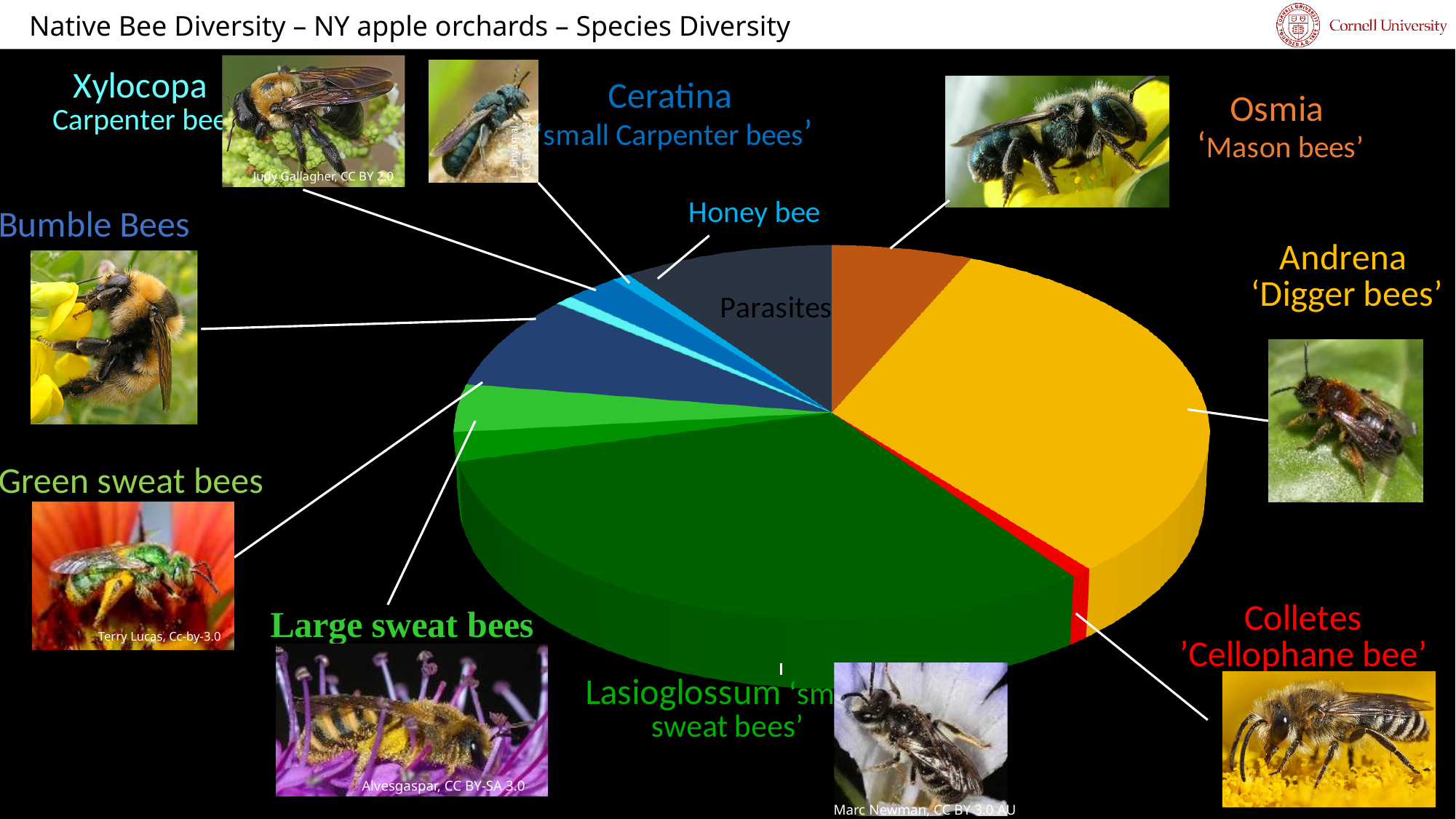
What colour is the Andrena 'Digger bees' slice of the pie chart? Yellow Which slice is larger, Andrena 'Digger bees' or Colletes 'Cellophane bee'? Andrena 'Digger bees' Which bee group has the largest slice of the pie chart? Andrena 'Digger bees' Which slice is larger, Andrena 'Digger bees' or Bumble Bees? Andrena 'Digger bees' Which slice is larger, Bumble Bees or Green sweat bees? Bumble Bees What kind of chart is shown on the slide? Pie chart How many slices (bee groups) does the pie chart have? 11 What is the title of the slide containing the pie chart? Native Bee Diversity – NY apple orchards – Species Diversity